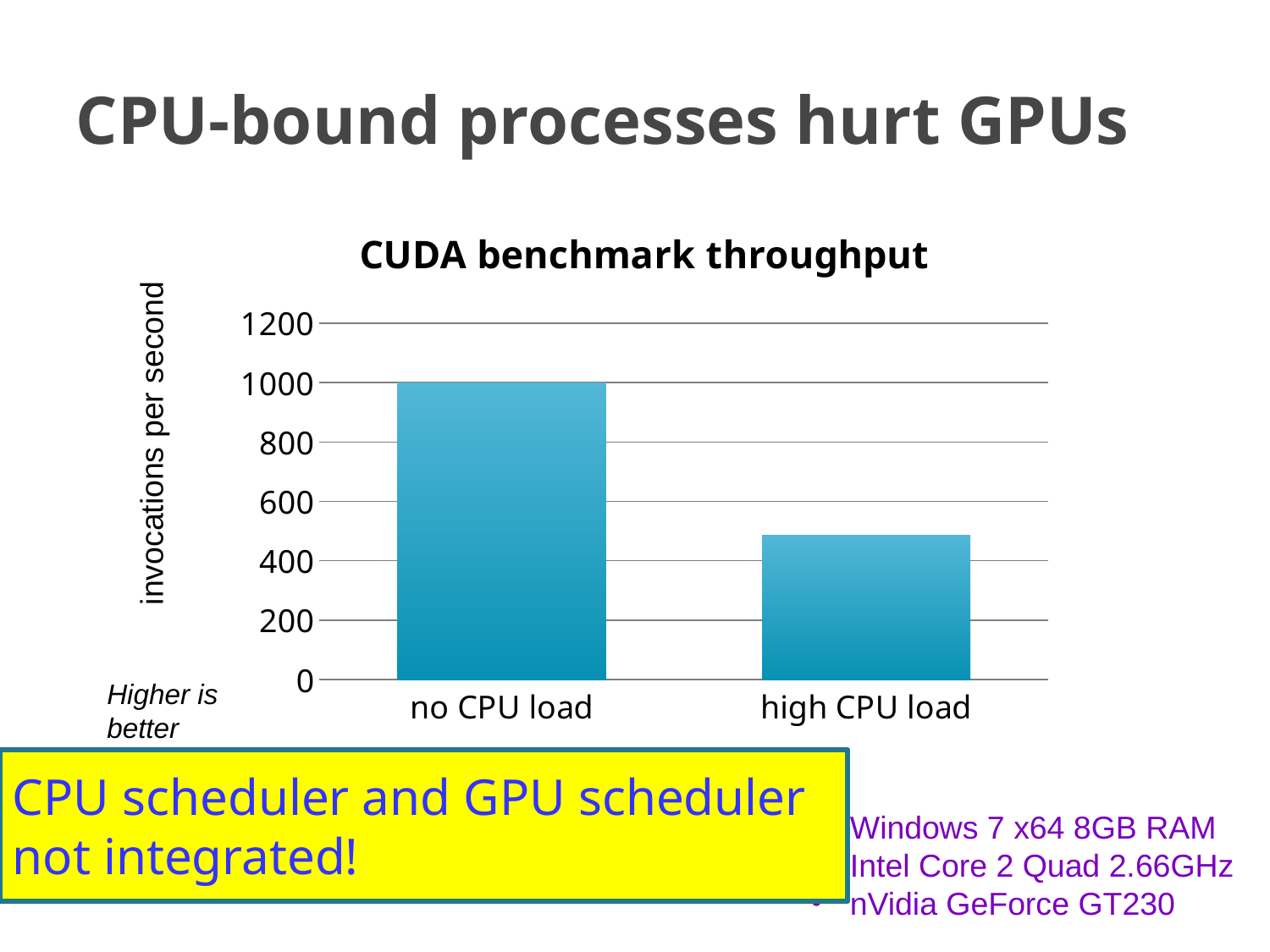
What is the highest tick value shown on the y axis? 1200 What is the label of the y axis? invocations per second Do the values rise or fall from "no CPU load" to "high CPU load"? fall Is the value for "high CPU load" greater or less than 400? greater Is the value for "high CPU load" greater or less than 600? less Which is larger, the value for "no CPU load" or the value for "high CPU load"? no CPU load How many categories are shown on the x axis of the chart? 2 Which category has the lowest throughput in the chart? high CPU load Which category has the highest throughput in the chart? no CPU load What kind of chart is shown on the slide? bar chart What is the title of the chart? CUDA benchmark throughput